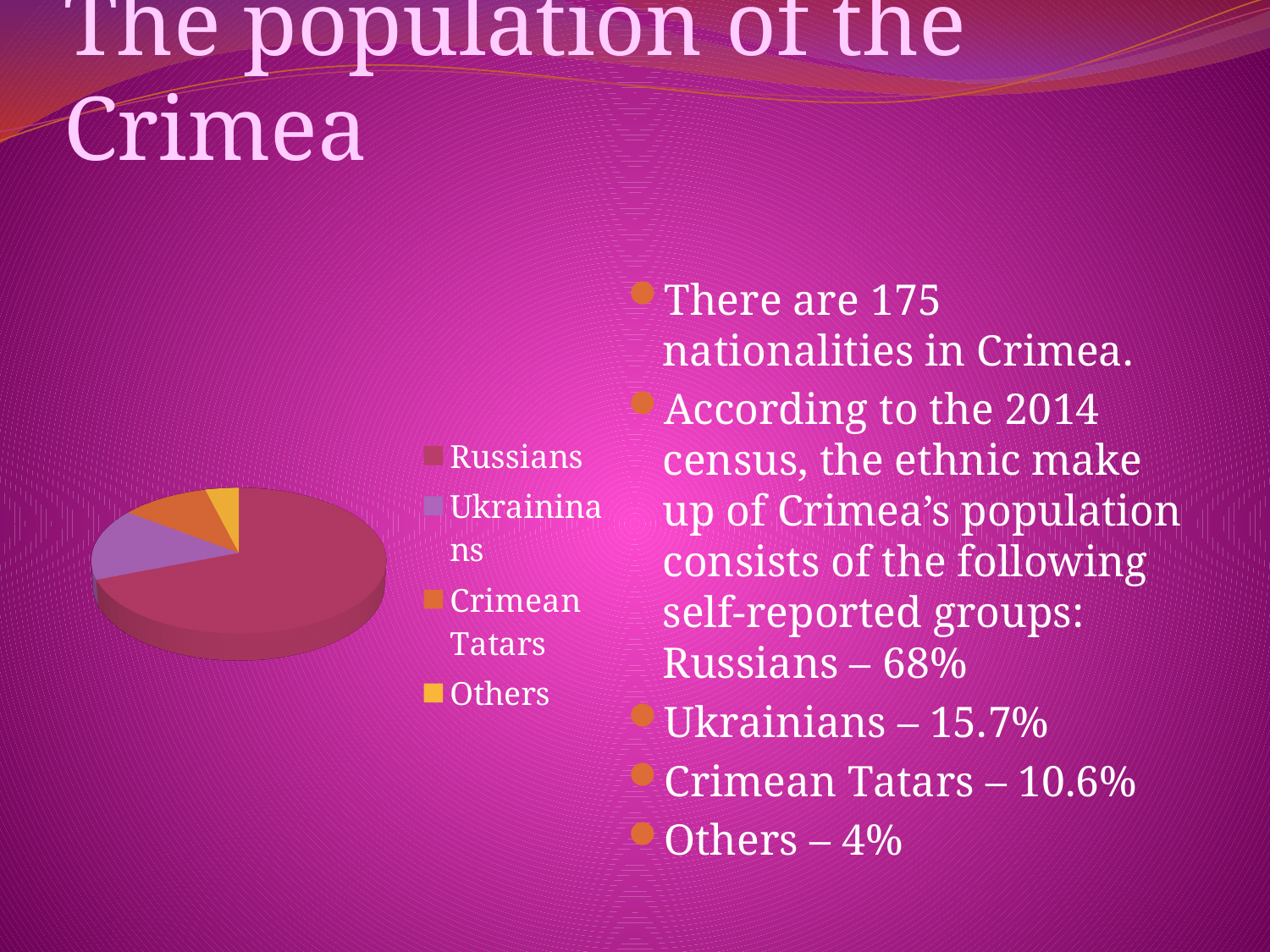
Which slice is larger in the pie chart, Ukrainians or Crimean Tatars? Ukrainians According to the slide, what percentage of Crimea's population is Crimean Tatars? 10.6% Which group has the largest slice of the pie chart? Russians According to the slide, what share of Crimea's population is Russians? 68% According to the slide, what percentage of Crimea's population is Others? 4% What kind of chart is shown on the slide? pie chart Which group has the smallest slice of the pie chart? Others How many slices does the pie chart have? 4 How many entries does the pie chart's legend list? 4 Which slice is larger in the pie chart, Crimean Tatars or Others? Crimean Tatars According to the slide, what percentage of Crimea's population is Ukrainians? 15.7% What colour is the Others slice in the pie chart? yellow